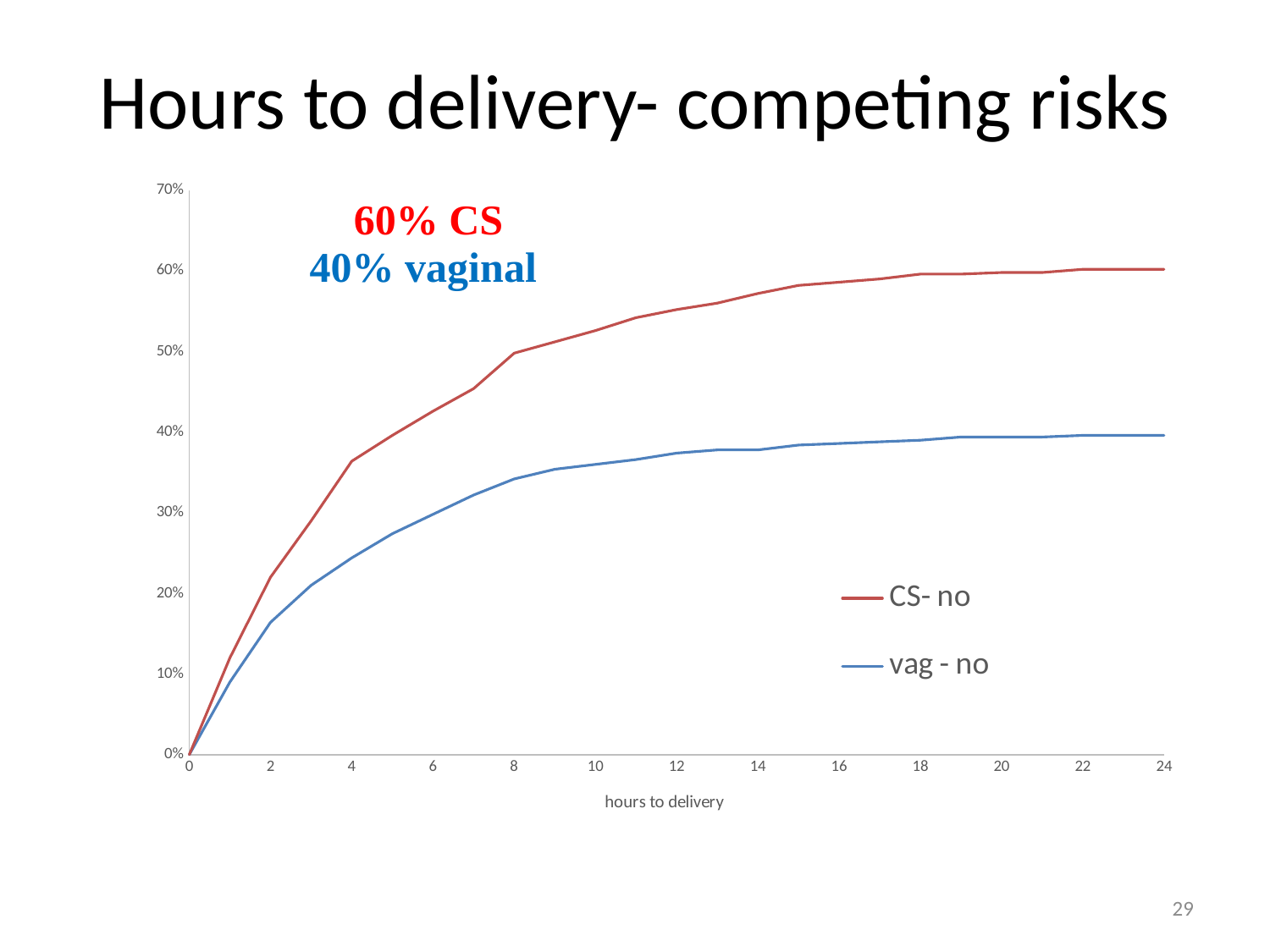
How many series does the legend list? 2 Which series is drawn in blue? vag - no Is the value for vag - no at 24 hours to delivery greater or less than 50%? less Is the value for vag - no at 8 hours to delivery greater or less than 40%? less Do the values for CS- no rise or fall as hours to delivery increase from 0 to 24? rise What kind of chart is shown on the slide? line chart Which series has the higher value at 24 hours to delivery, CS- no or vag - no? CS- no Is the value for CS- no at 4 hours to delivery greater or less than 30%? greater What are the two series named in the legend? CS- no and vag - no What is the label of the x axis? hours to delivery